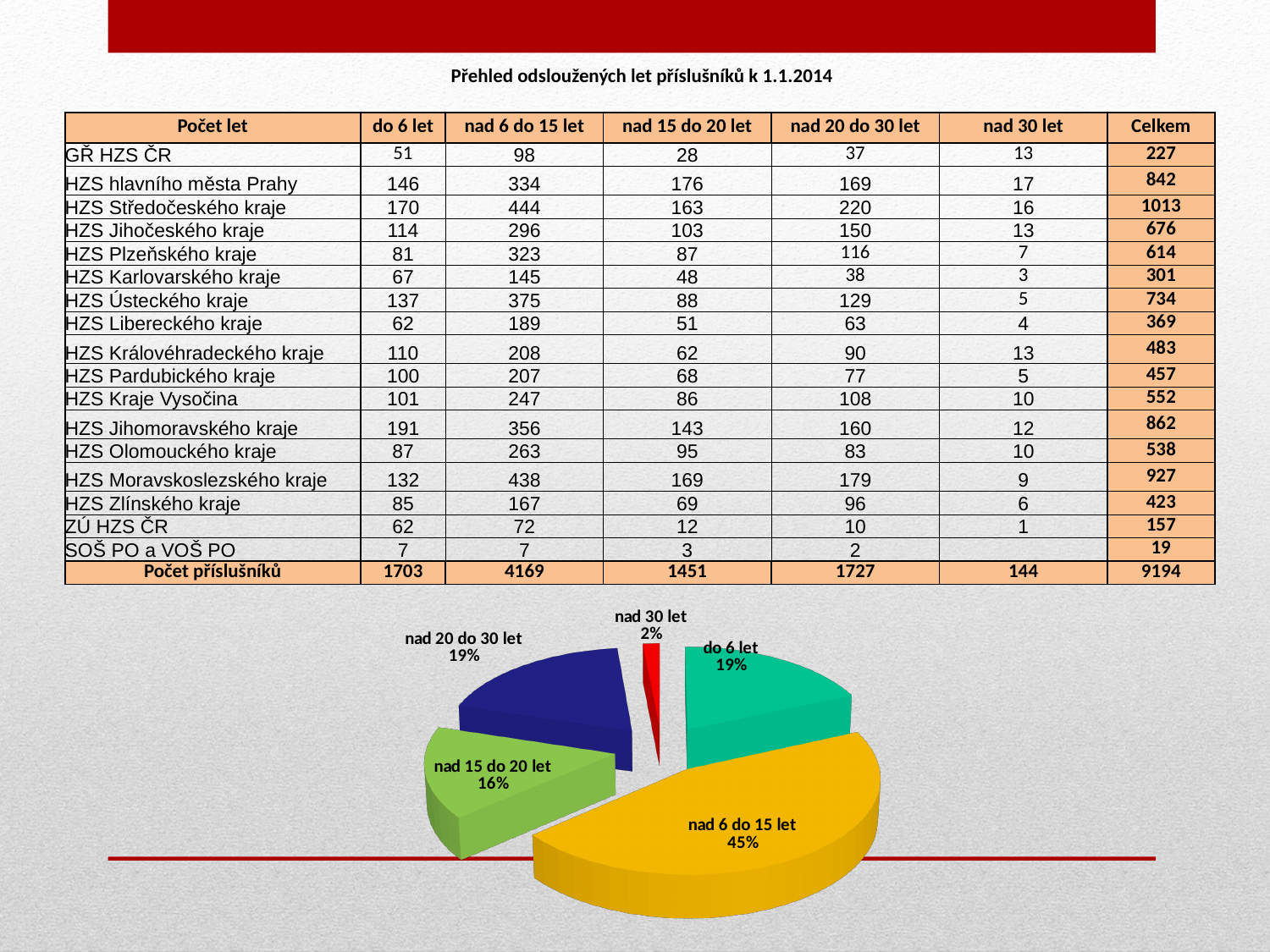
Which slice of the pie chart is the largest? nad 6 do 15 let In the pie chart, which slice is larger: 'nad 15 do 20 let' or 'nad 20 do 30 let'? nad 20 do 30 let What colour is the 'nad 30 let' slice in the pie chart? red In the pie chart, what is the combined share of 'do 6 let' and 'nad 20 do 30 let'? 38% Which slice of the pie chart is the smallest? nad 30 let In the pie chart, what is the difference in percentage points between 'nad 6 do 15 let' and 'nad 15 do 20 let'? 29 How many slices does the pie chart have? 5 What share of the pie chart does the slice 'nad 6 do 15 let' represent? 45% What share of the pie chart does the slice 'nad 15 do 20 let' represent? 16% What kind of chart is shown on the slide? pie chart What share of the pie chart does the slice 'nad 30 let' represent? 2%